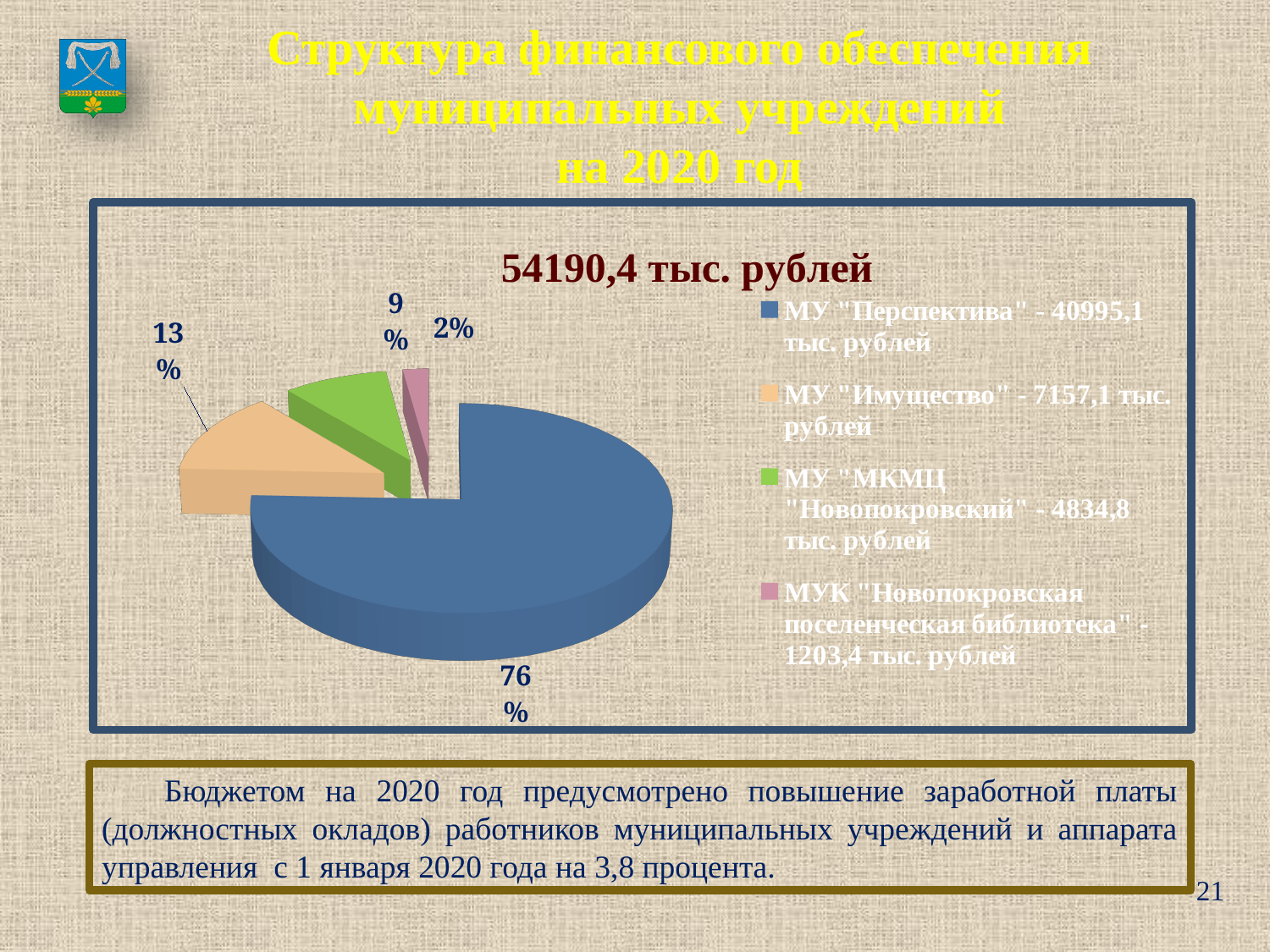
How many slices does the pie chart have? 4 Which has a larger share: МУ "Имущество" or МУ "МКМЦ "Новопокровский"? МУ "Имущество" What is the title of the chart? 54190,4 тыс. рублей What is the difference in percentage points between the share of МУ "Перспектива" and the share of МУ "Имущество"? 63 What share of the pie does МУ "МКМЦ "Новопокровский" have? 9% What share of the pie does МУ "Имущество" have? 13% Which institution has the smallest slice of the pie? МУК "Новопокровская поселенческая библиотека" Which institution has the largest slice of the pie? МУ "Перспектива" How many entries does the legend list? 4 What kind of chart is shown on the slide? pie chart What share of the pie does МУК "Новопокровская поселенческая библиотека" have? 2%